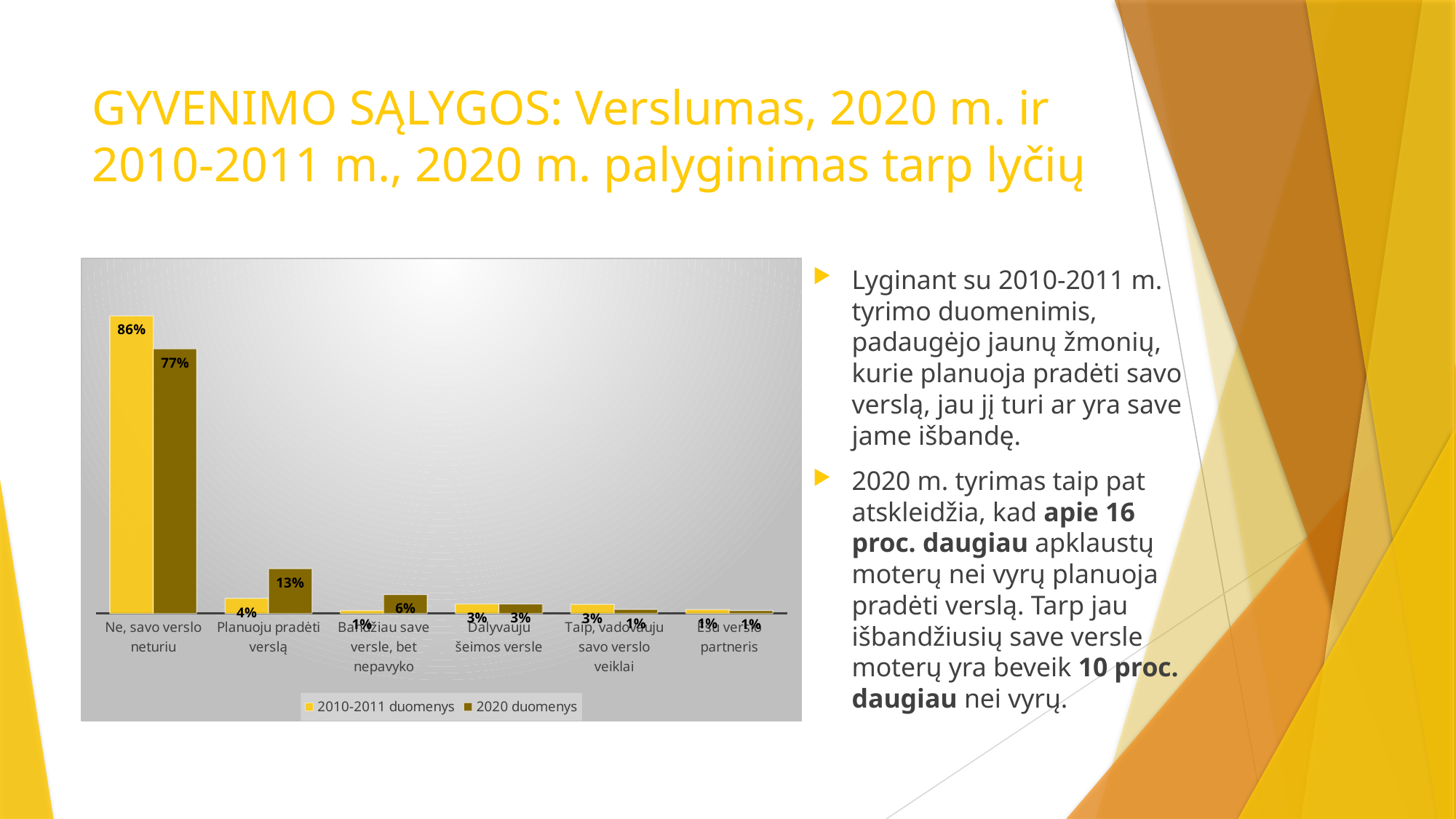
What are the two legend entries of the chart? 2010-2011 duomenys and 2020 duomenys What is the difference between the 2010-2011 duomenys and 2020 duomenys values for "Ne, savo verslo neturiu"? 9% Which category has the highest value in the 2020 duomenys series? Ne, savo verslo neturiu For "Planuoju pradėti verslą", which series has the larger value, 2010-2011 duomenys or 2020 duomenys? 2020 duomenys What type of chart is shown on the slide? bar chart What is the value for "Ne, savo verslo neturiu" in the 2010-2011 duomenys series? 86% How many series does the chart legend list? 2 How many categories are shown on the x axis of the chart? 6 What is the value for "Planuoju pradėti verslą" in the 2010-2011 duomenys series? 4% What is the difference between the 2020 duomenys and 2010-2011 duomenys values for "Planuoju pradėti verslą"? 9% What is the value for "Ne, savo verslo neturiu" in the 2020 duomenys series? 77% What is the value for "Planuoju pradėti verslą" in the 2020 duomenys series? 13%